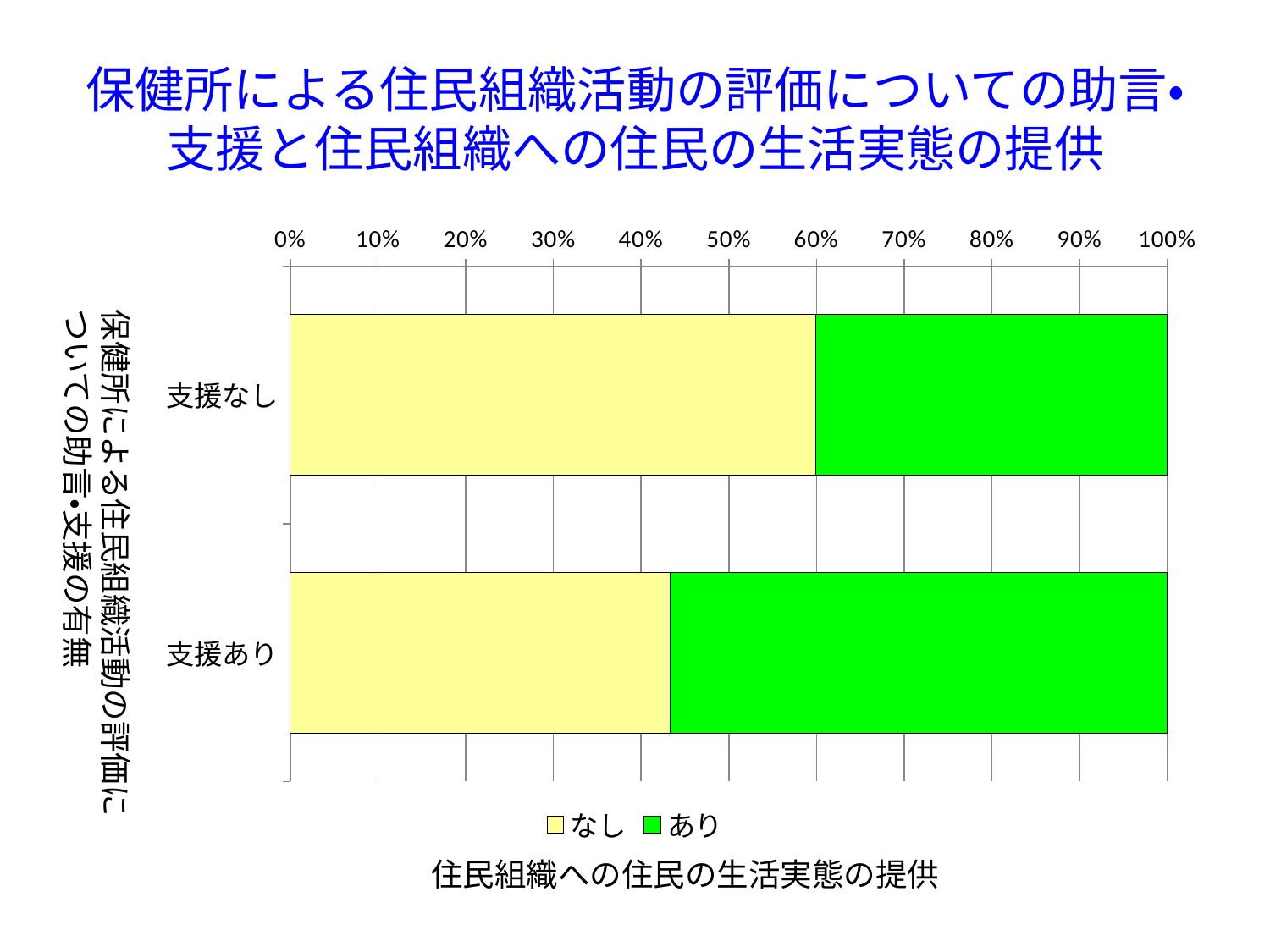
Is the value of あり for 支援なし greater or less than 50%? less How many series does the chart legend list? 2 Is the value of あり for 支援あり greater or less than 50%? greater Which category has the larger share of なし, 支援なし or 支援あり? 支援なし Is the value of なし for 支援あり greater or less than 50%? less Which colour represents the series あり in the chart? green What are the two series listed in the chart legend? なし, あり Which category has the larger share of あり, 支援なし or 支援あり? 支援あり How many categories are shown on the vertical axis of the chart? 2 What kind of chart is shown on the slide? bar chart What is the maximum value shown on the horizontal axis of the chart? 100%